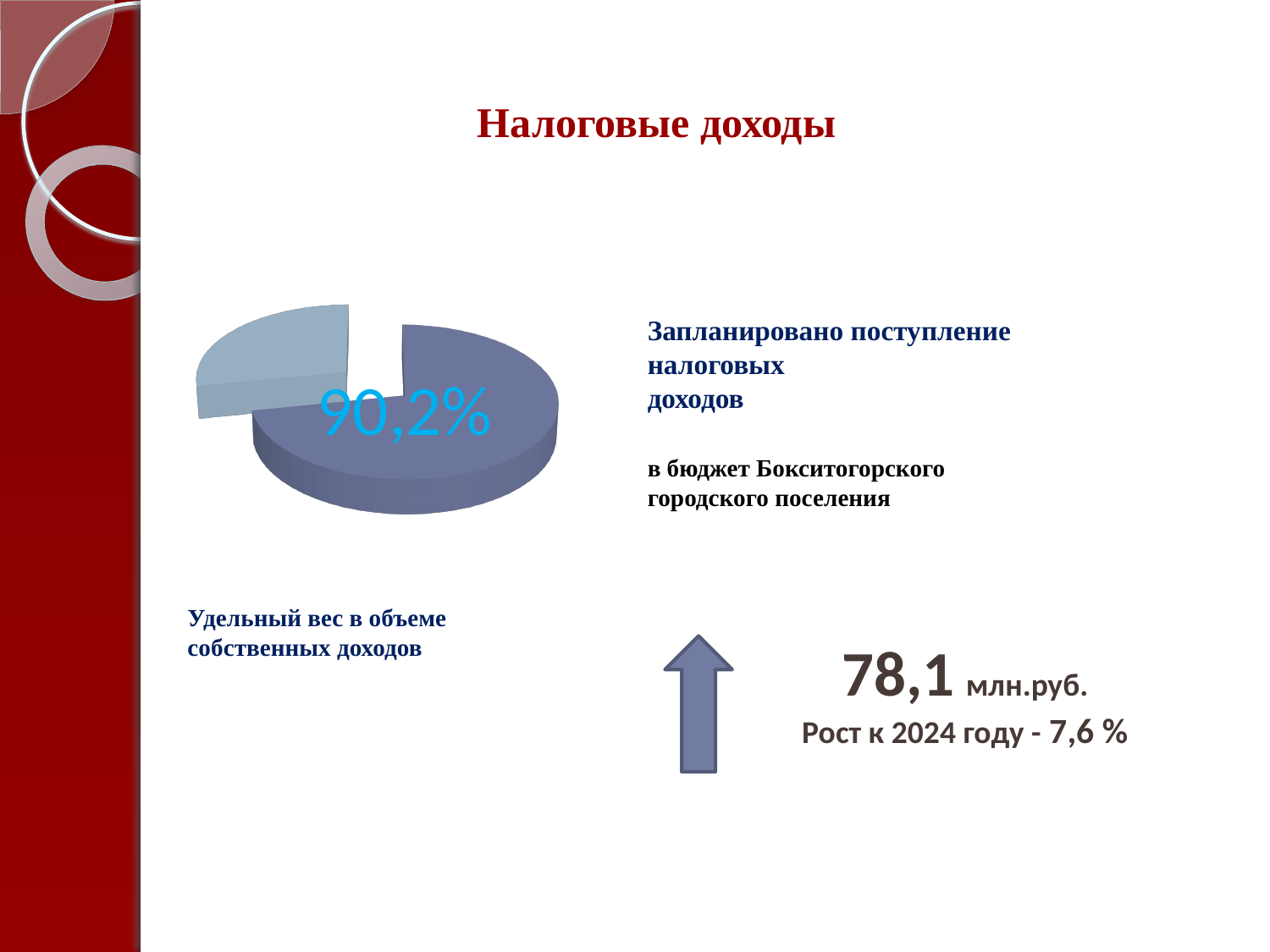
What share of the pie does the labelled slice represent? 90,2% Which slice of the pie chart is larger, the dark blue one or the light blue one? the dark blue one What colour is the slice labelled 90,2%? dark blue How many slices does the pie chart have? 2 What percentage is printed on the large slice of the pie chart? 90,2% What is the title shown above the pie chart on the slide? Налоговые доходы What kind of chart is shown on the slide? pie chart